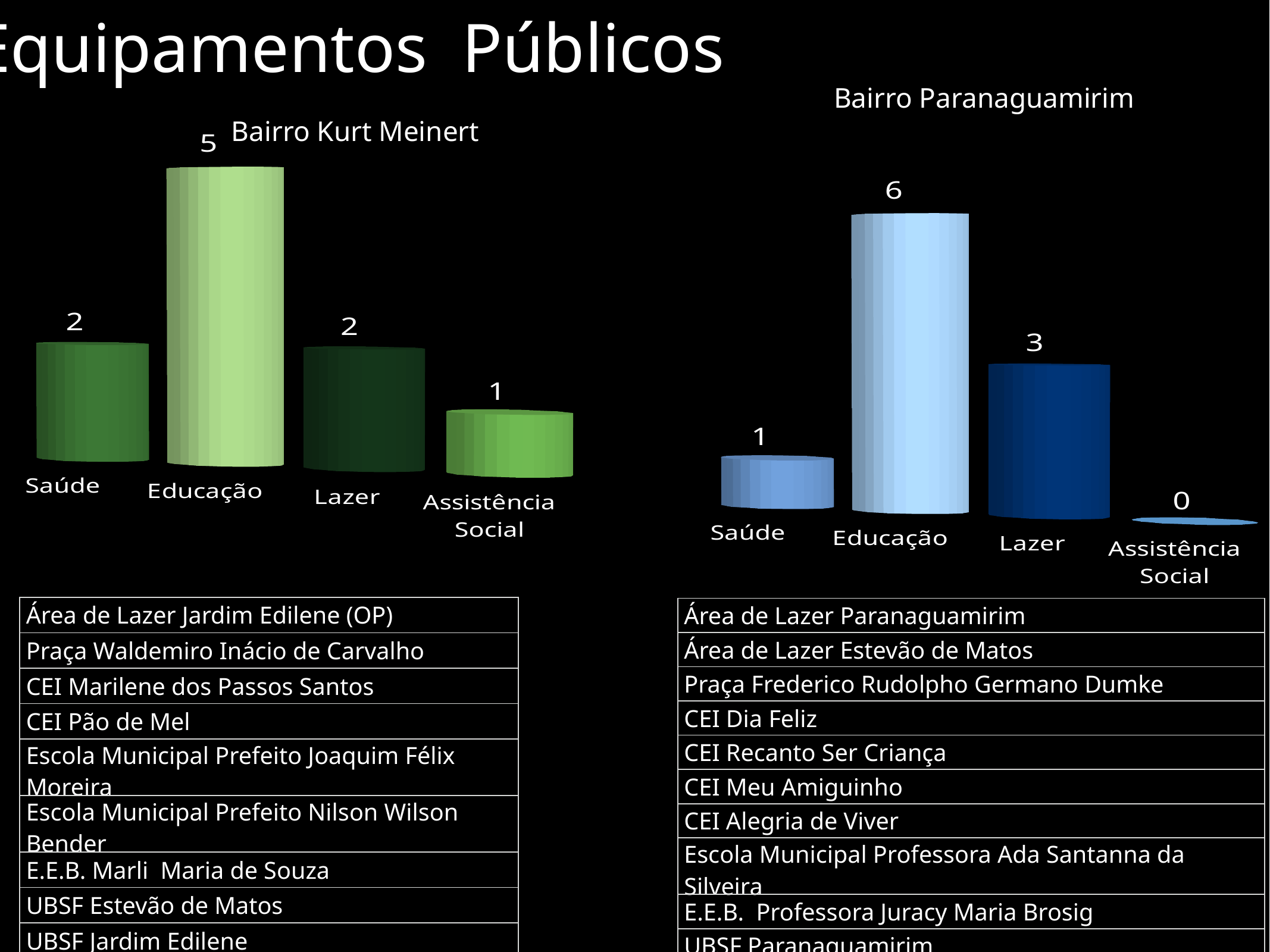
How many categories are shown in the Bairro Paranaguamirim chart? 4 In the Bairro Kurt Meinert chart, what is the value for Assistência Social? 1 In the Bairro Paranaguamirim chart, what is the value for Lazer? 3 In the Bairro Paranaguamirim chart, which category has the lowest value? Assistência Social In the Bairro Kurt Meinert chart, what is the difference between Educação and Saúde? 3 In the Bairro Kurt Meinert chart, what is the value for Educação? 5 Which is larger: Saúde in the Bairro Kurt Meinert chart or Saúde in the Bairro Paranaguamirim chart? Bairro Kurt Meinert In the Bairro Paranaguamirim chart, what is the difference between Educação and Lazer? 3 In the Bairro Paranaguamirim chart, what is the value for Assistência Social? 0 In the Bairro Kurt Meinert chart, which category has the highest value? Educação What kind of chart is the Bairro Kurt Meinert chart? Bar chart What is the total of all values in the Bairro Paranaguamirim chart? 10